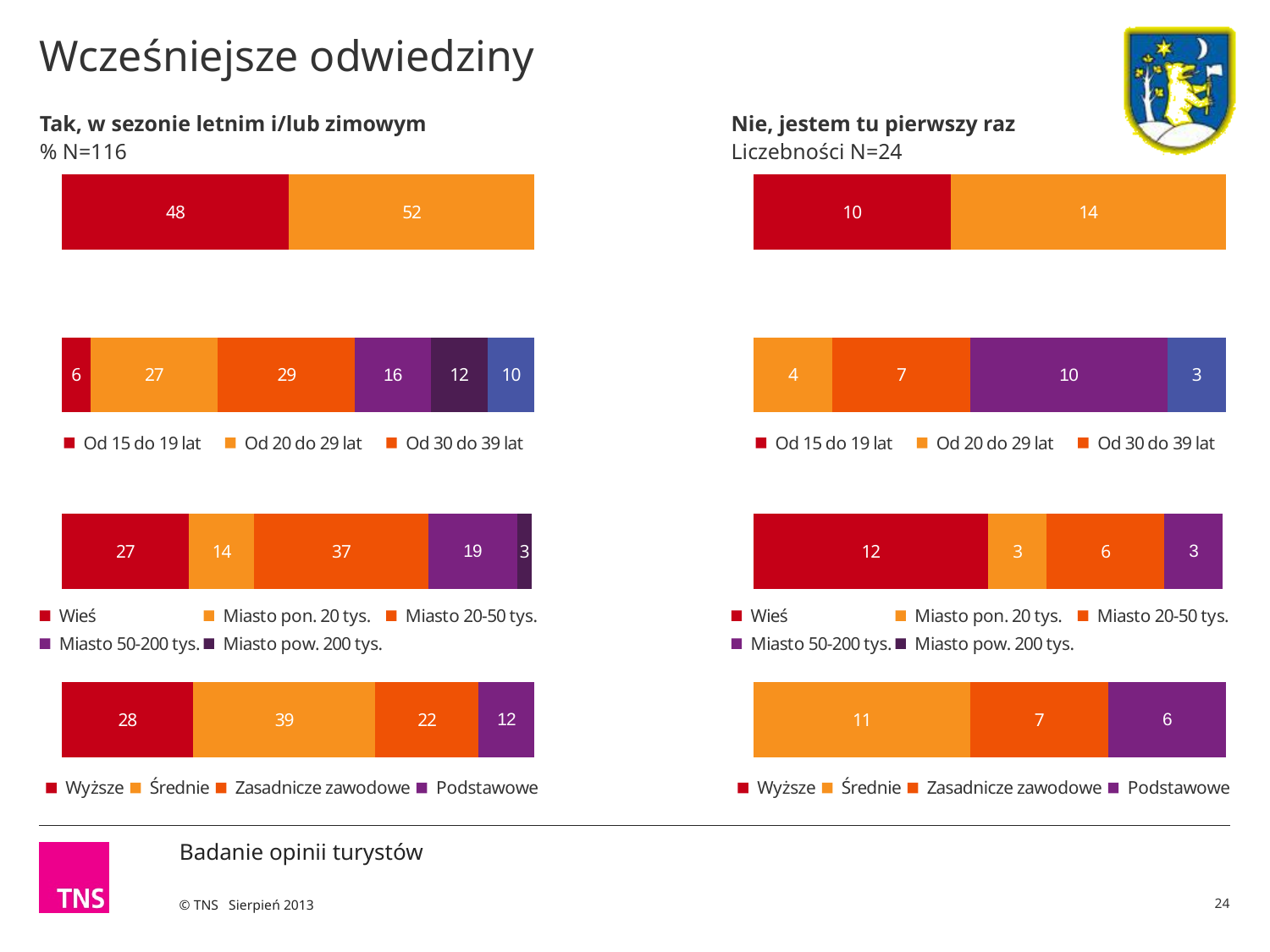
In the education chart under "Nie, jestem tu pierwszy raz", what is the value for Podstawowe? 6 In the education chart under "Tak, w sezonie letnim i/lub zimowym", what is the value for Średnie? 39 What kind of chart is used for the education breakdown under "Nie, jestem tu pierwszy raz"? Stacked bar chart How many entries does the legend of the education chart under "Tak, w sezonie letnim i/lub zimowym" list? 4 In the education chart under "Tak, w sezonie letnim i/lub zimowym", which category has the highest value? Średnie In the age chart under "Tak, w sezonie letnim i/lub zimowym", what is the value for Od 15 do 19 lat? 6 In the top bar under "Nie, jestem tu pierwszy raz", what is the total of the two segments? 24 In the education chart under "Tak, w sezonie letnim i/lub zimowym", what is the difference between Wyższe and Podstawowe? 16 In the place-of-residence chart under "Tak, w sezonie letnim i/lub zimowym", which category has the lowest value? Miasto pow. 200 tys. In the place-of-residence chart under "Nie, jestem tu pierwszy raz", what is the value for Wieś? 12 In the age chart under "Nie, jestem tu pierwszy raz", which is larger: Od 20 do 29 lat or Od 30 do 39 lat? Od 30 do 39 lat In the place-of-residence chart under "Tak, w sezonie letnim i/lub zimowym", what is the value for Miasto 20-50 tys.? 37